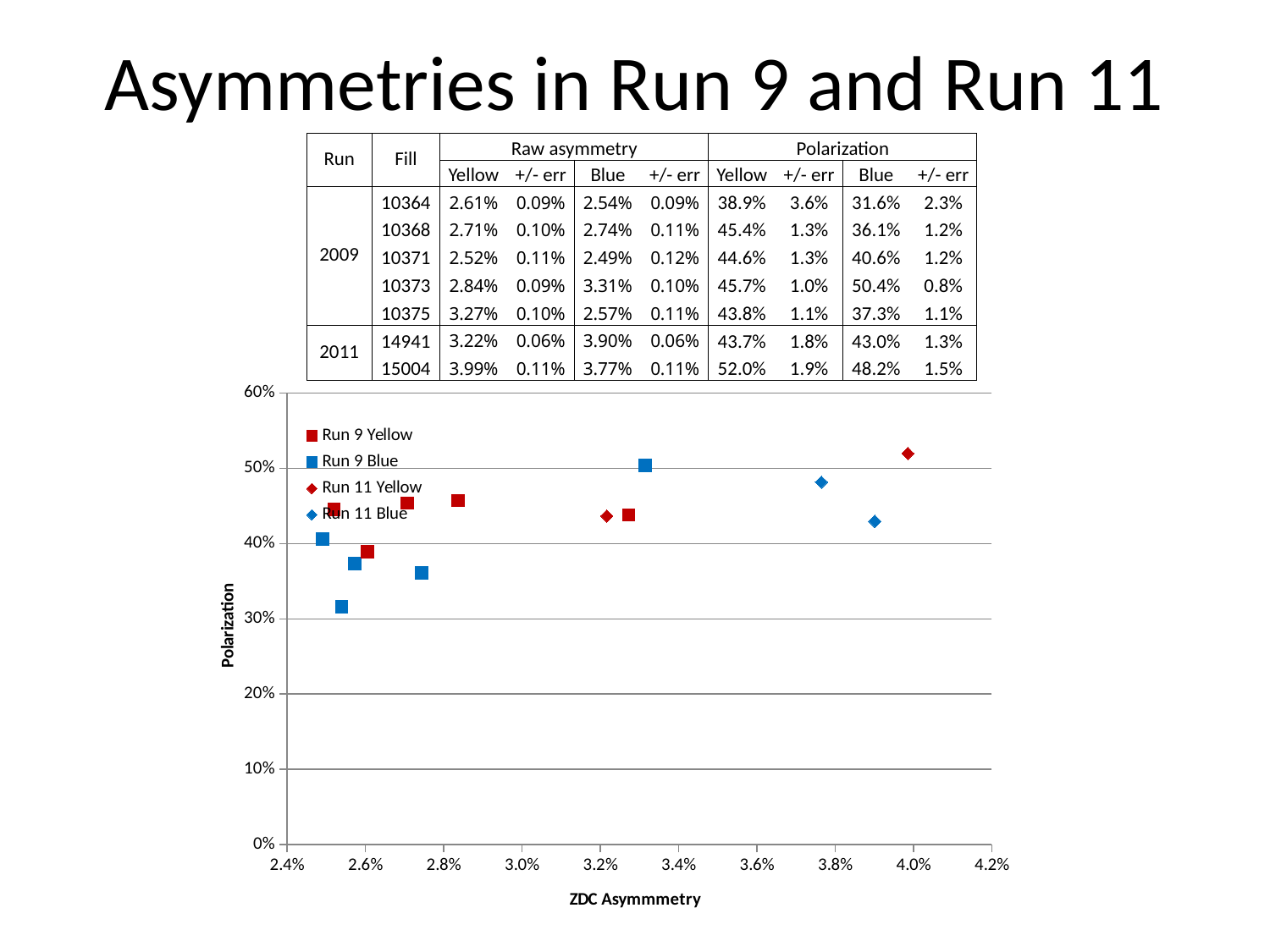
What kind of chart is shown below the table on the slide? scatter chart Which series contains the point with the highest polarization on the chart? Run 11 Yellow Which is higher on the chart: the lowest Run 9 Yellow point or the lowest Run 9 Blue point? the lowest Run 9 Yellow point Is the polarization of the highest Run 11 Yellow point greater or less than 50%? greater Which series contains the point with the lowest polarization on the chart? Run 9 Blue How many Run 9 Yellow points are plotted on the chart? 5 What is the title of the chart's x axis? ZDC Asymmmetry How many Run 11 Blue points are plotted on the chart? 2 Do the Run 11 Yellow points rise or fall in polarization as ZDC asymmetry increases? rise How many series does the chart's legend list? 4 What is the title of the chart's y axis? Polarization Is the polarization of the lowest Run 9 Blue point greater or less than 40%? less